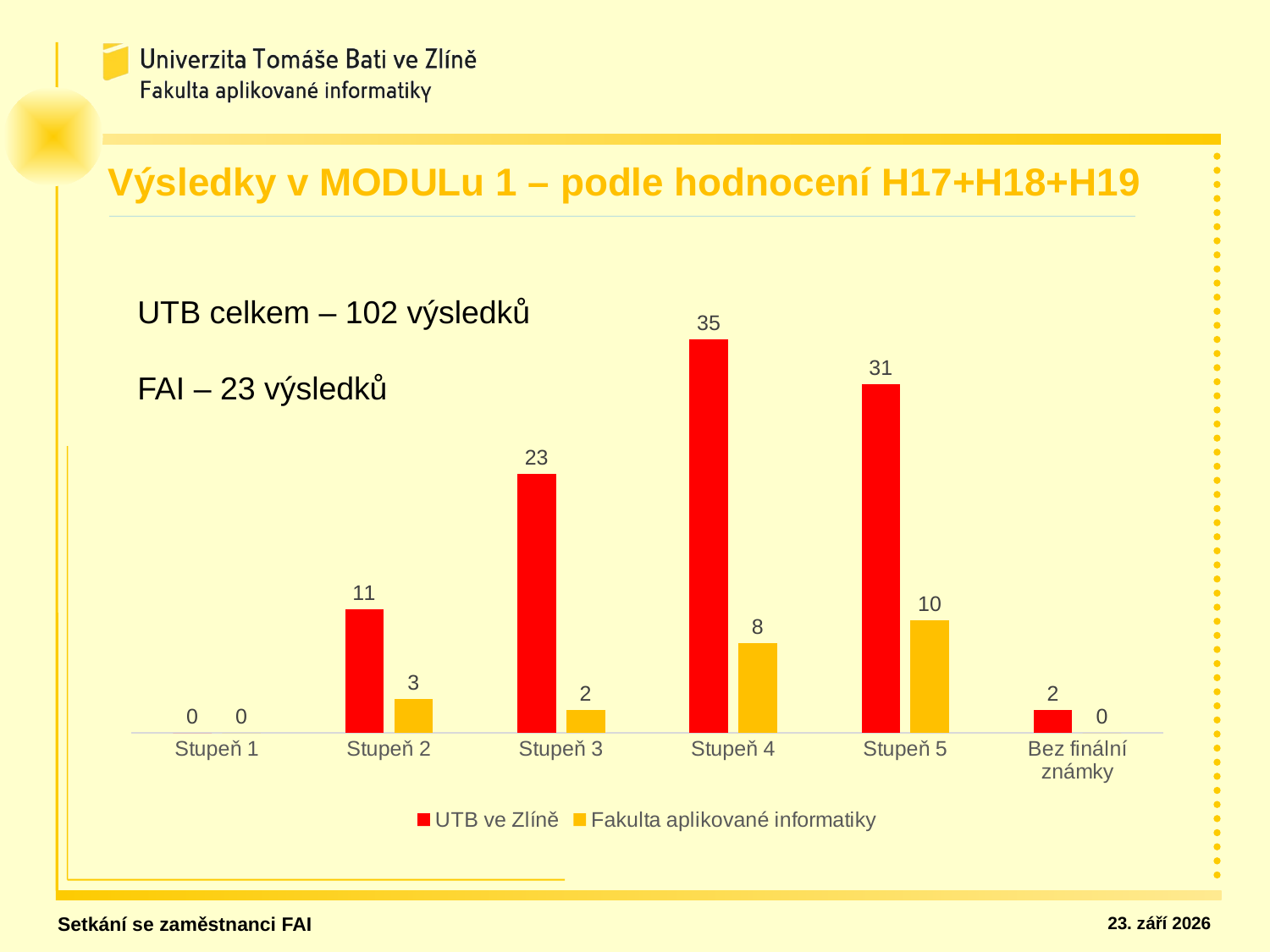
How many categories are shown on the x axis? 6 Which category has the highest value for Fakulta aplikované informatiky? Stupeň 5 Which is larger: the Fakulta aplikované informatiky value at Stupeň 2 or at Stupeň 4? Stupeň 4 What is the difference between the UTB ve Zlíně and Fakulta aplikované informatiky values at Stupeň 3? 21 What kind of chart is shown on the slide? bar chart What is the difference between the UTB ve Zlíně values at Stupeň 4 and Stupeň 5? 4 What is the value for UTB ve Zlíně at Bez finální známky? 2 What is the value for Fakulta aplikované informatiky at Stupeň 5? 10 Which category has the highest value for UTB ve Zlíně? Stupeň 4 How many series does the legend list? 2 What colour are the bars for UTB ve Zlíně? red What is the value for UTB ve Zlíně at Stupeň 4? 35